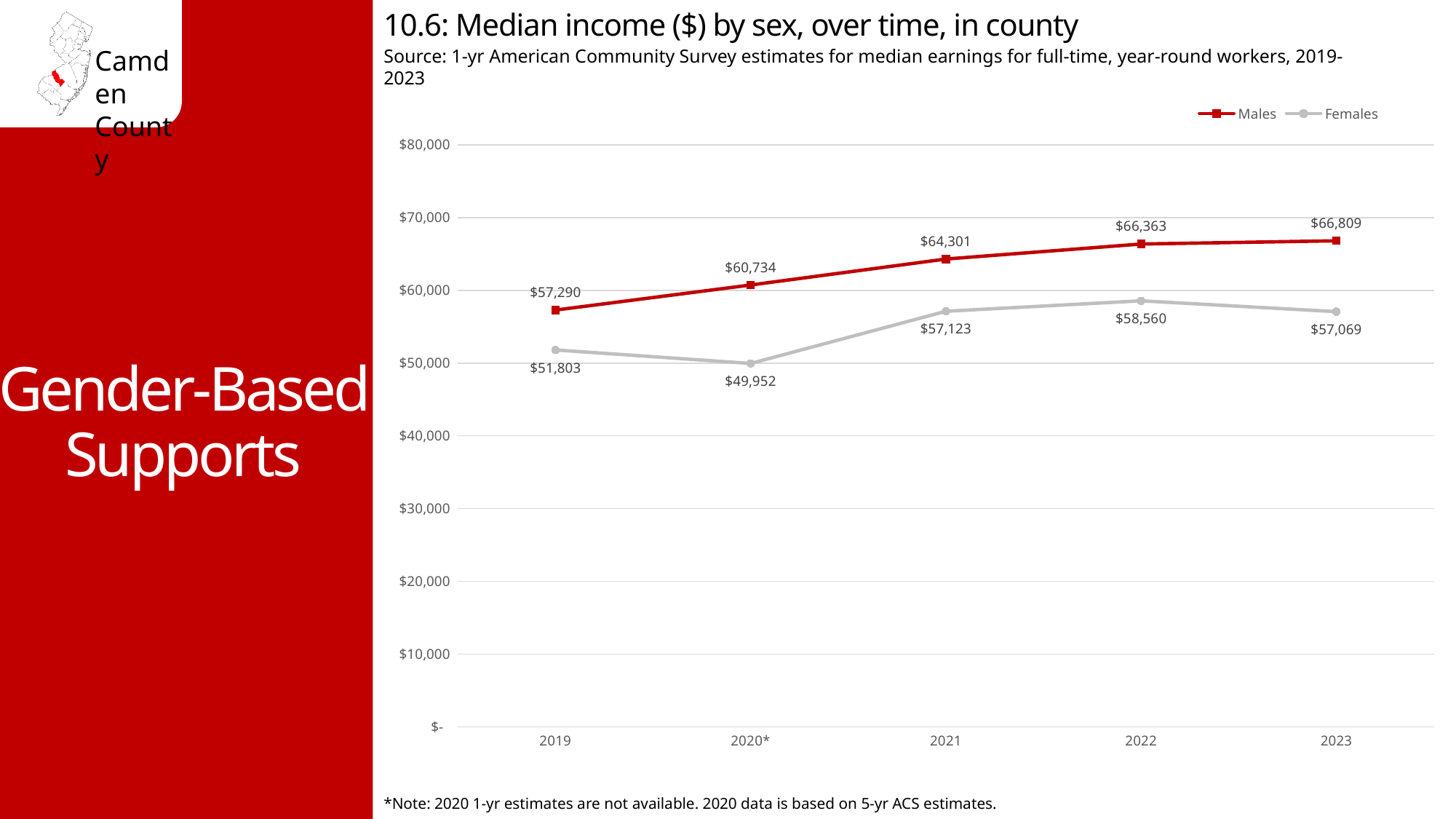
Does the Males median income rise or fall from 2019 to 2023? Rise What is the median income for Males in 2021? $64,301 What is the median income for Females in 2023? $57,069 What is the difference between the Males and Females median income in 2023? $9,740 In which year is the Males median income highest? 2023 What kind of chart is this? Line chart What is the median income for Females in 2020*? $49,952 What is the difference between the Males median income in 2019 and in 2023? $9,519 Which is larger, the Females median income in 2022 or in 2021? 2022 How many years are shown on the x axis? 5 How many series does the legend list? 2 In which year is the Females median income lowest? 2020*